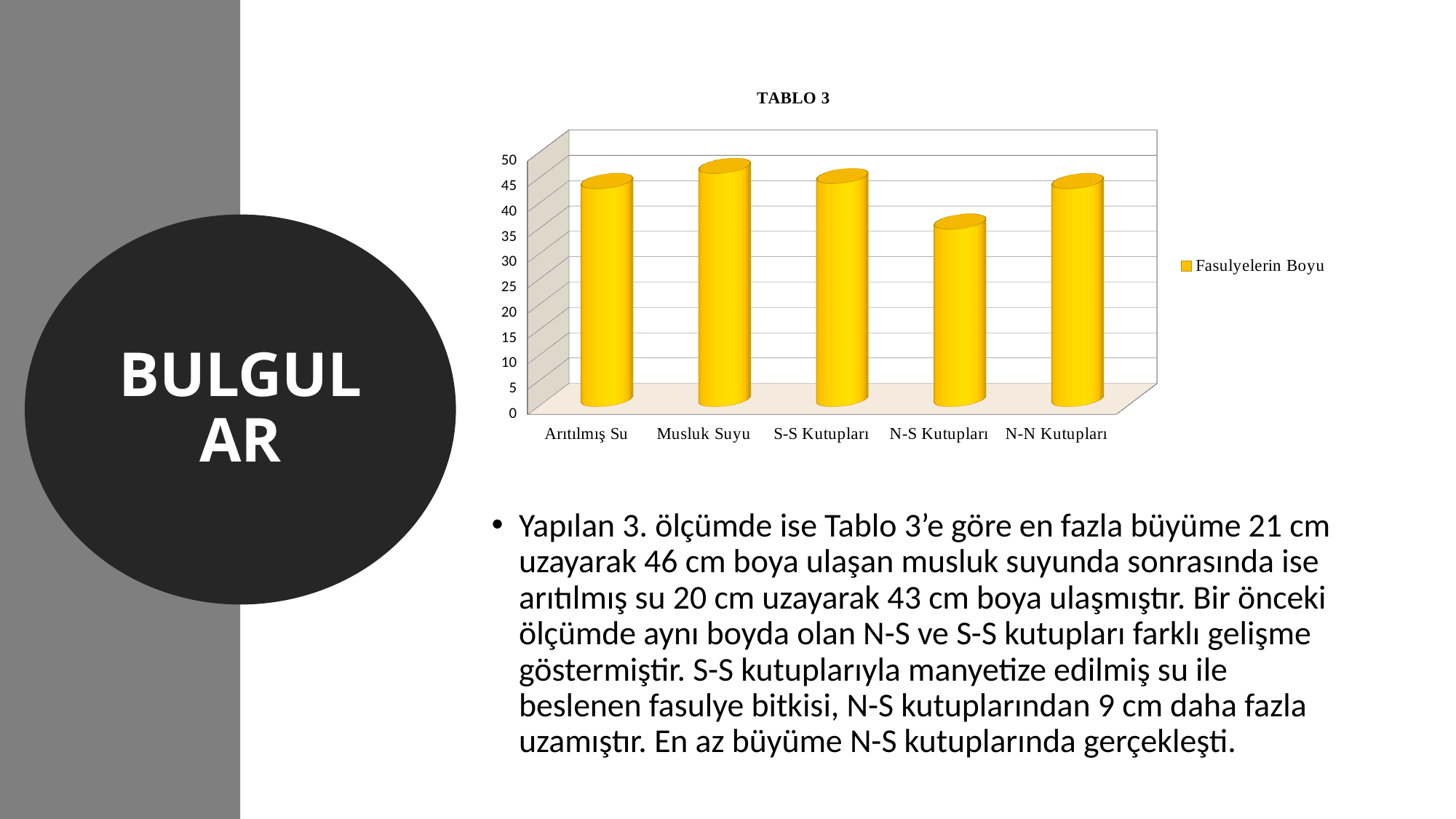
How many series does the chart's legend list? 1 Which category has the lowest bar in the chart? N-S Kutupları Is the value for Musluk Suyu greater or less than 40? greater Which is larger, the value for Musluk Suyu or the value for N-S Kutupları? Musluk Suyu What is the title of the chart? TABLO 3 Which category has the highest bar in the chart? Musluk Suyu What kind of chart is shown on the slide? bar chart Is the value for N-S Kutupları greater or less than 40? less Which is larger, the value for S-S Kutupları or the value for N-S Kutupları? S-S Kutupları What is the name of the series in the chart's legend? Fasulyelerin Boyu How many categories are shown on the x axis of the chart? 5 Is the value for Arıtılmış Su greater or less than 30? greater